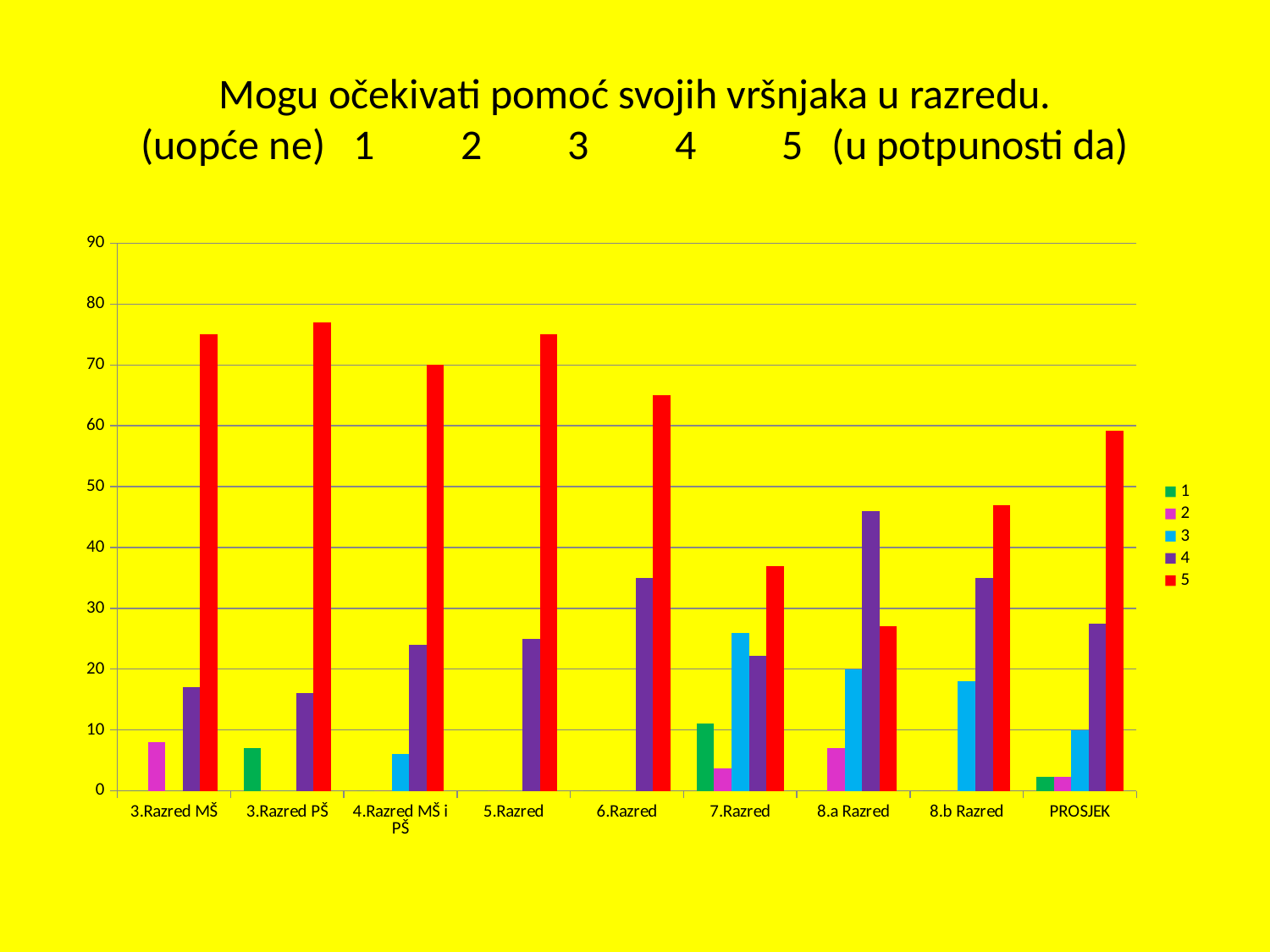
Is the value of series 4 for 8.a Razred greater or less than 40? greater How many series does the legend list? 5 For 8.a Razred, which series has the larger value, series 4 or series 5? 4 What kind of chart is shown on the slide? bar chart Is the value of series 5 for 8.b Razred greater or less than 40? greater How many categories are shown along the x axis? 9 Is the value of series 5 for PROSJEK greater or less than 50? greater Which category has the lowest value for series 5? 8.a Razred What are the legend entries of the chart? 1, 2, 3, 4, 5